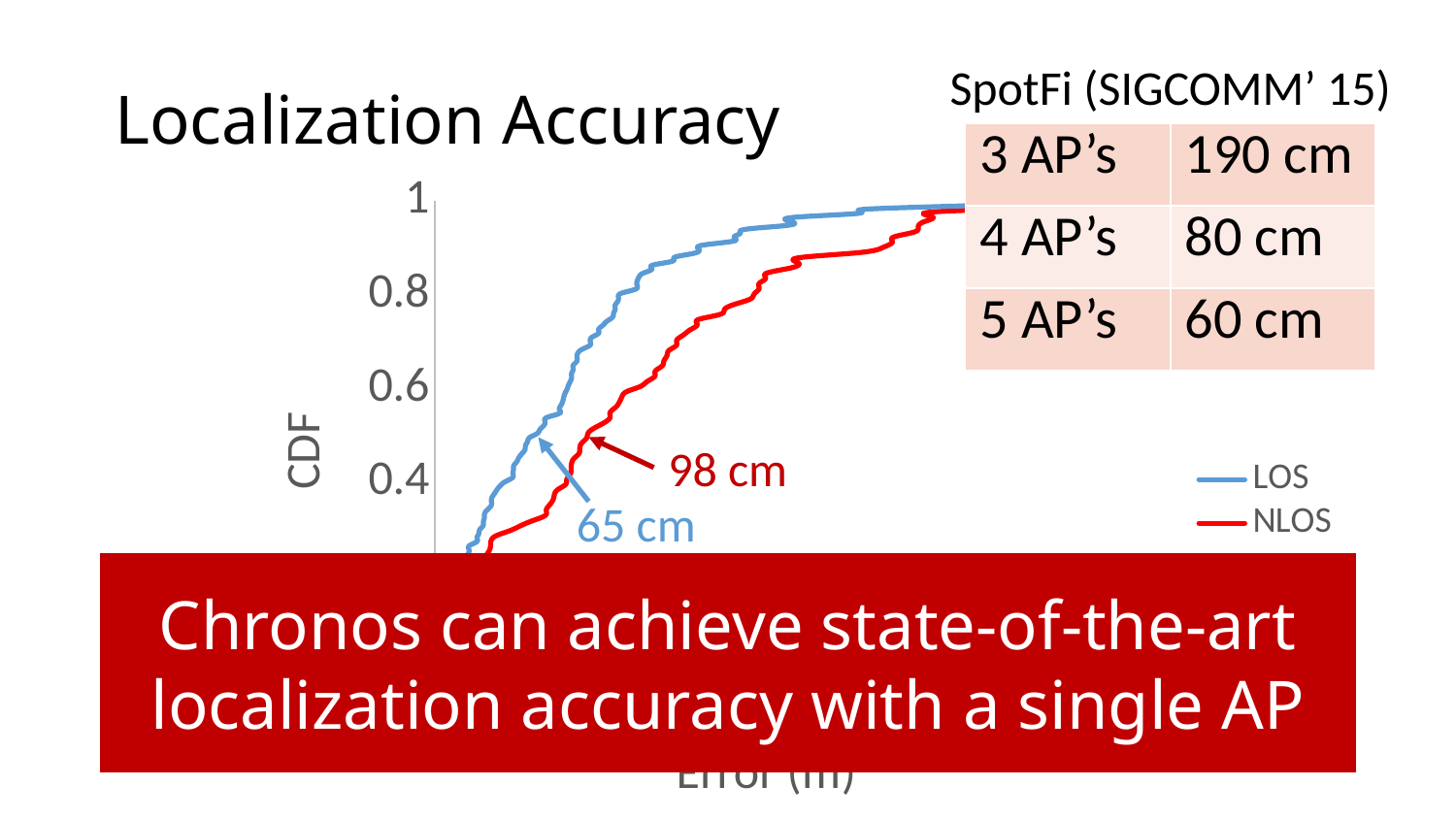
Do the CDF curves rise or fall as the error increases along the x axis? rise Which series reaches a CDF of 0.8 at a smaller error, LOS or NLOS? LOS What is the highest tick value shown on the CDF axis? 1 What error value is annotated on the NLOS curve? 98 cm What is the title of the chart? Localization Accuracy How many series does the chart's legend list? 2 What kind of chart is shown on the slide? line chart Which series has the lower annotated error value? LOS What are the two series named in the chart's legend? LOS and NLOS What is the difference between the annotated NLOS error and the annotated LOS error? 33 cm Which series has the larger annotated error value, LOS or NLOS? NLOS What error value is annotated on the LOS curve? 65 cm